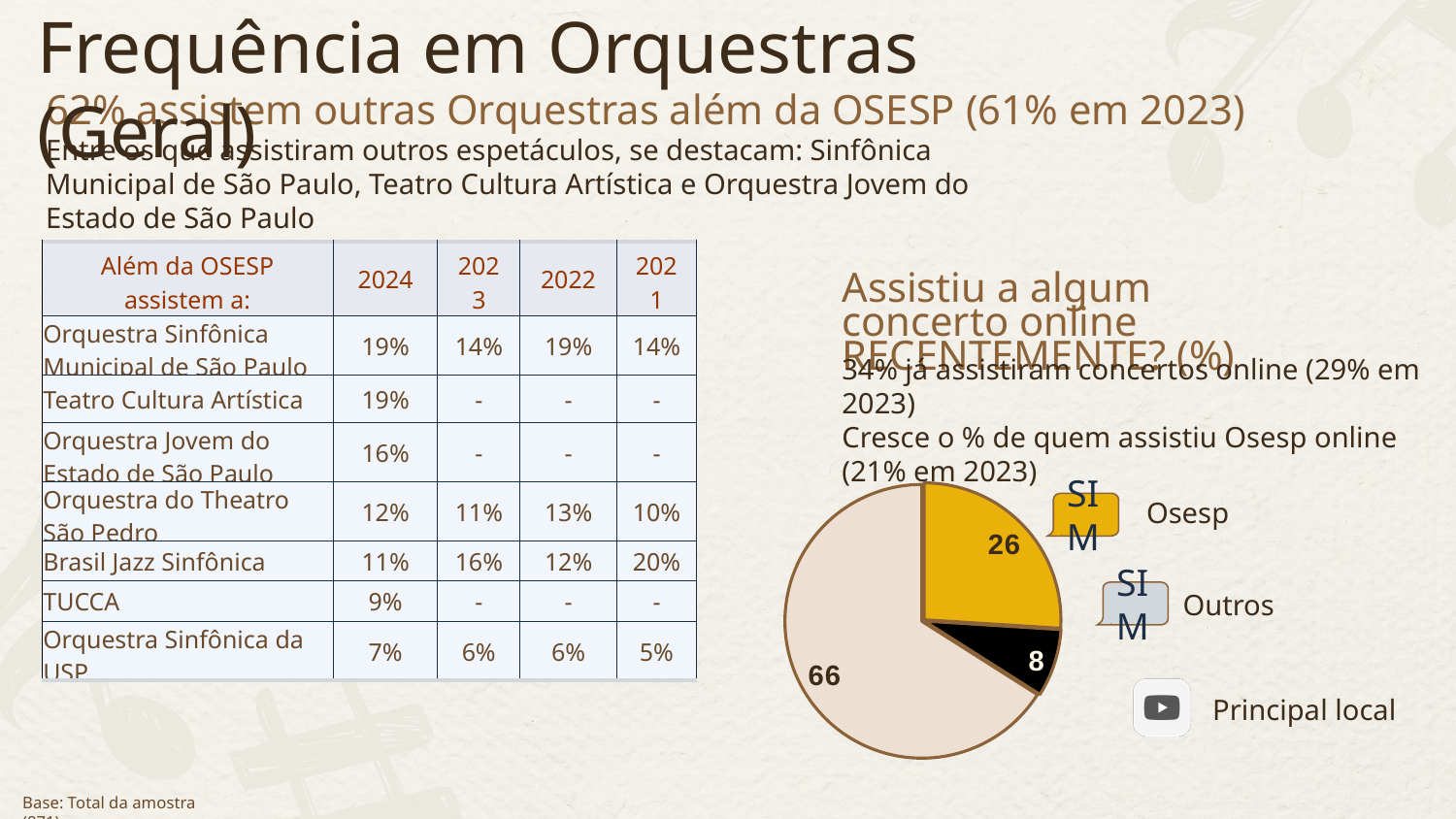
In the pie chart, what is the value for the 'SIM Outros' slice? 8 In the pie chart, what share of the whole pie does the 'SIM Osesp' slice represent? 26% In the pie chart, which is larger: the 'SIM Osesp' slice or the 'SIM Outros' slice? SIM Osesp In the pie chart, what is the value of the largest slice? 66 In the pie chart, which legend entry corresponds to the smallest slice? SIM Outros What is the total of all the slice values shown in the pie chart? 100 What kind of chart is shown on the right side of the slide? pie chart How many slices does the pie chart have? 3 In the pie chart, what is the value for the 'SIM Osesp' slice? 26 In the pie chart, what is the difference between the 'SIM Osesp' slice and the 'SIM Outros' slice? 18 In the pie chart, what colour is the 'SIM Osesp' slice? yellow What is the title of the pie chart? Assistiu a algum concerto online RECENTEMENTE? (%)